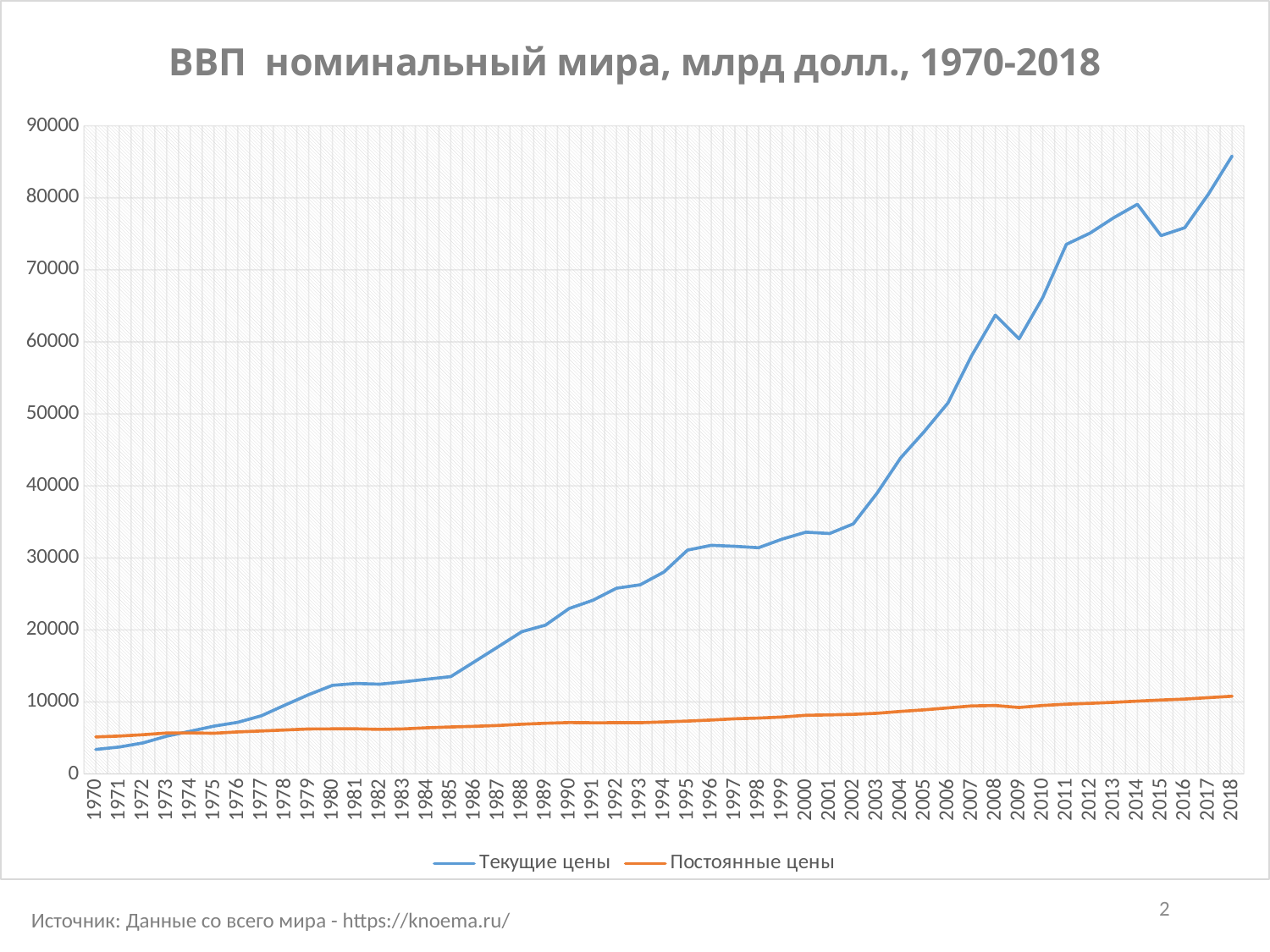
What is the title of the chart? ВВП номинальный мира, млрд долл., 1970-2018 Is the value for Постоянные цены in 2018 greater or less than 10000? greater In which year does the Текущие цены series reach its highest value? 2018 How many years are plotted along the x axis? 49 How many series does the legend list? 2 What are the two series named in the legend? Текущие цены and Постоянные цены Is the value for Текущие цены in 2018 greater or less than 80000? greater In which year is the Текущие цены series at its lowest value? 1970 Is the value for Текущие цены in 2008 greater or less than 60000? greater What kind of chart is shown on the slide? line chart Which series has the larger value in 2010, Текущие цены or Постоянные цены? Текущие цены Does the Постоянные цены series generally rise or fall from 1970 to 2018? rise